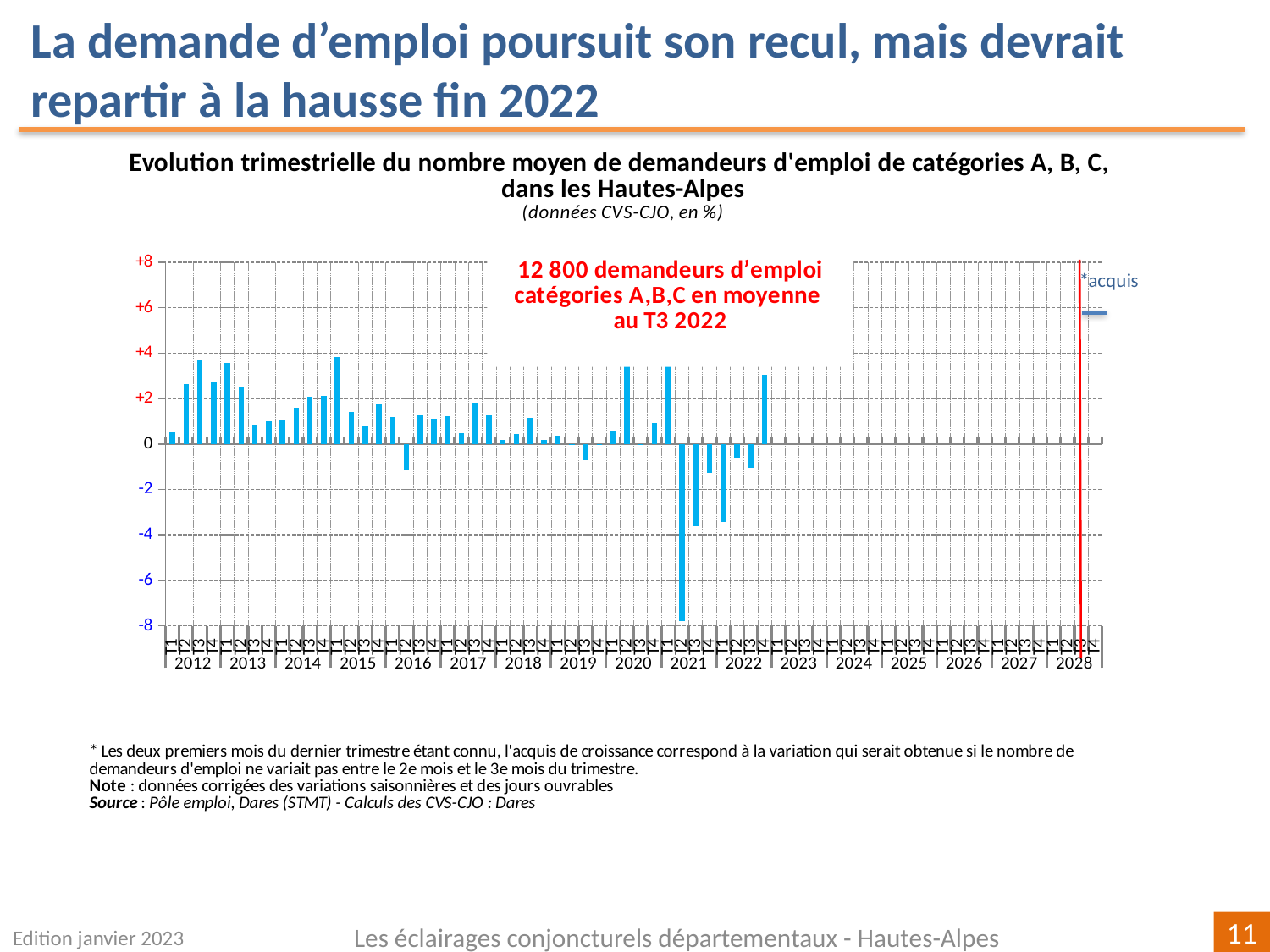
According to the red annotation on the chart, how many job seekers in categories A, B, C were there on average in T3 2022? 12 800 Is the value for T3 2012 greater or less than +2? greater Is the value for T3 2021 greater or less than -2? less Is the value for T2 2021 greater or less than -6? less Which quarter has the lowest value in the chart? T2 2021 Which is larger, the value for T2 2021 or the value for T3 2021? T3 2021 What kind of chart is shown on the slide? bar chart Do the values rise or fall from T2 2021 to T4 2021? rise How many years are labelled on the x axis of the chart? 17 Which is larger, the value for T3 2012 or the value for T3 2013? T3 2012